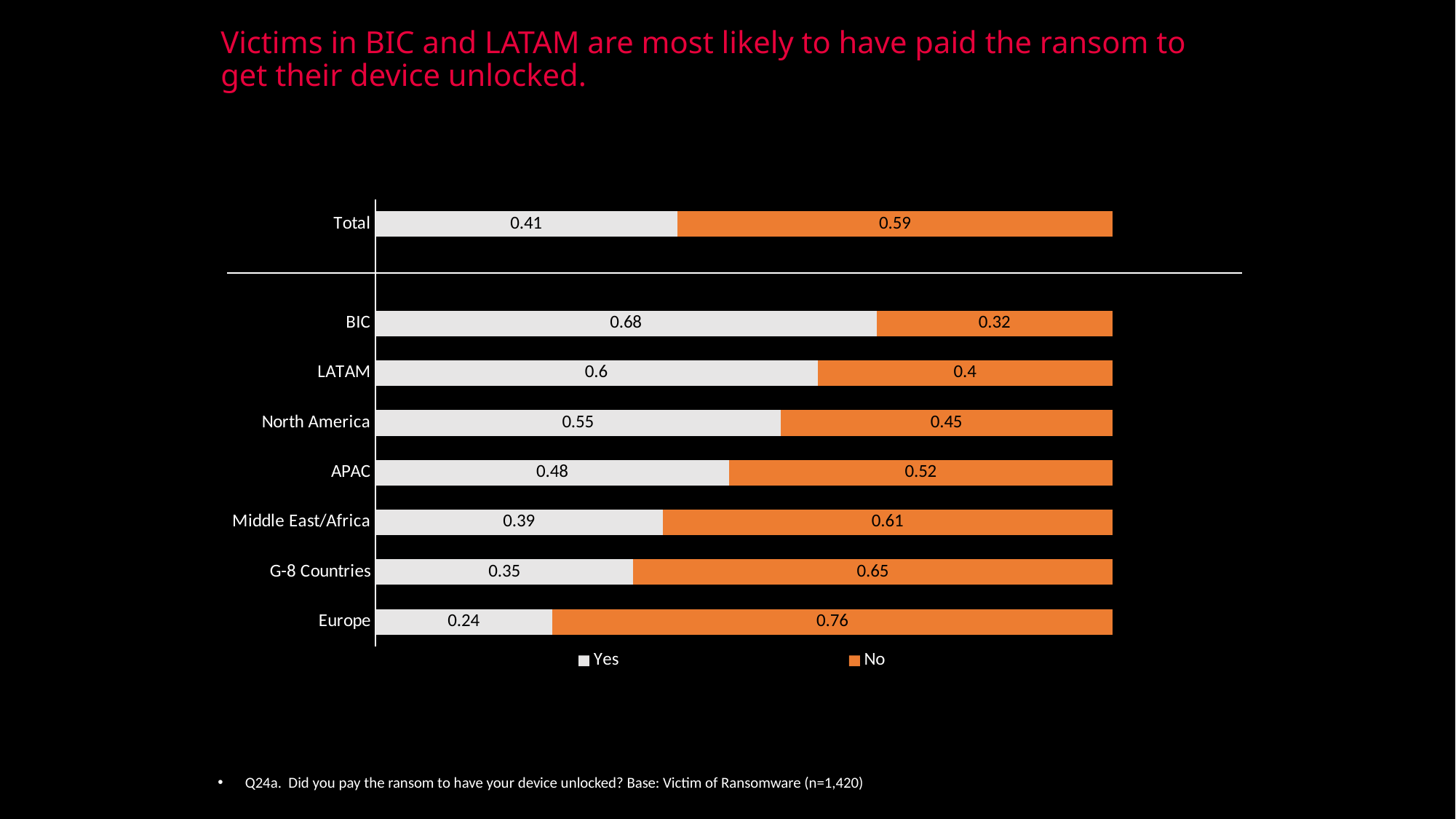
Which region has the highest Yes value? BIC Which is larger, the No value for G-8 Countries or the No value for Middle East/Africa? G-8 Countries What is the Yes value for BIC? 0.68 What is the total of the stacked bar for Middle East/Africa? 1 How many series does the legend list? 2 What is the difference between the Yes values for LATAM and North America? 0.05 What kind of chart is shown on the slide? Stacked bar chart Which region has the lowest Yes value? Europe How many categories are shown on the chart, including Total? 8 What is the No value for APAC? 0.52 What is the Yes value for Total? 0.41 What is the No value for Europe? 0.76